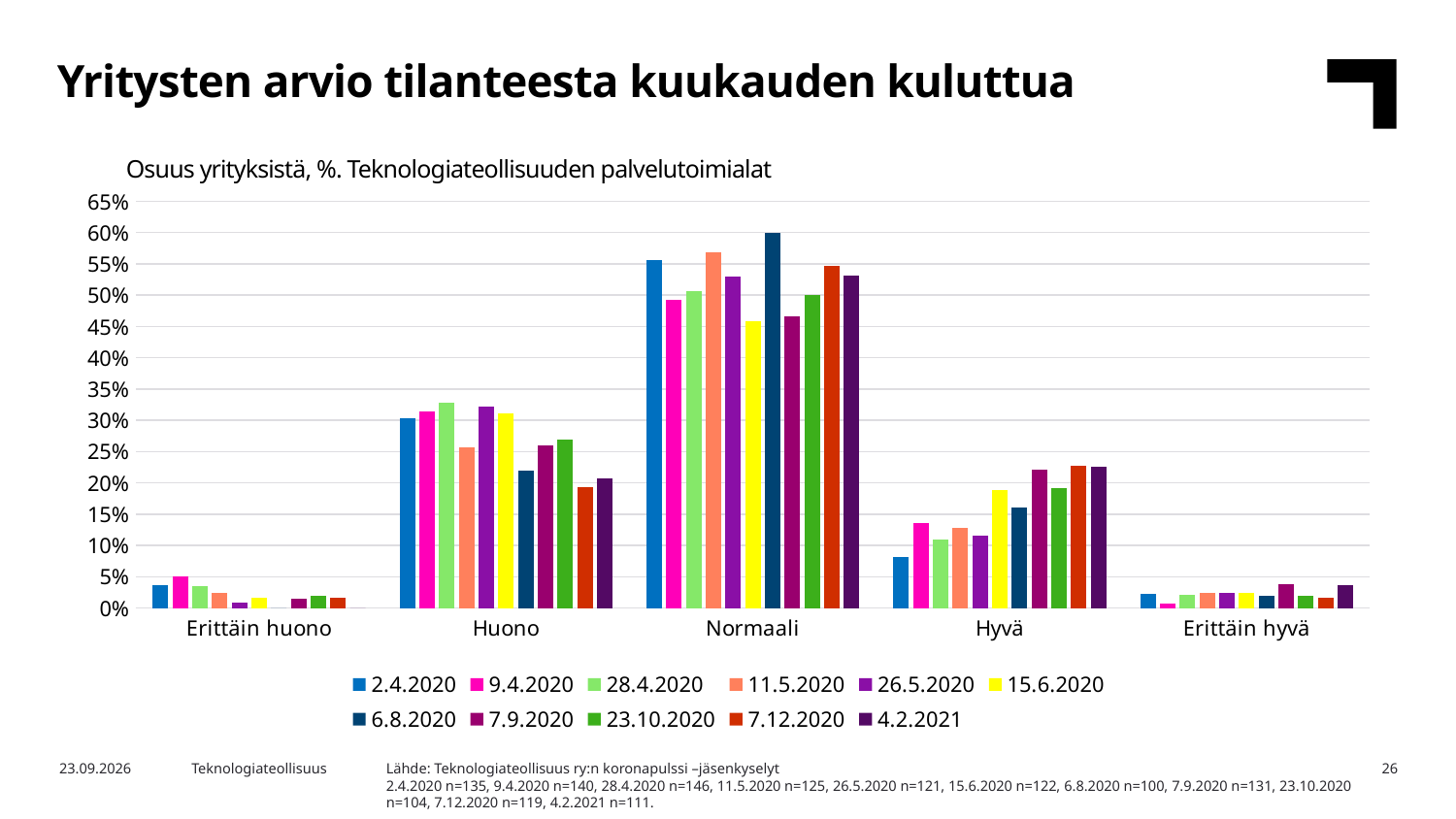
Within the Normaali category, which series has the highest value? 6.8.2020 What is the subtitle shown above the chart? Osuus yrityksistä, %. Teknologiateollisuuden palvelutoimialat Is the value for 6.8.2020 in the Normaali category greater or less than 55%? greater Which category has the tallest bars overall in the chart? Normaali Is the value for 15.6.2020 in the Normaali category greater or less than 50%? less What kind of chart is shown on the slide? bar chart Is the value for 2.4.2020 in the Hyvä category greater or less than 10%? less How many categories are shown on the x axis of the chart? 5 How many series does the chart's legend list? 11 In the Hyvä category, which is larger: the value for 4.2.2021 or the value for 2.4.2020? 4.2.2021 In the Normaali category, which is larger: the value for 6.8.2020 or the value for 9.4.2020? 6.8.2020 Within the Hyvä category, which series has the lowest value? 2.4.2020